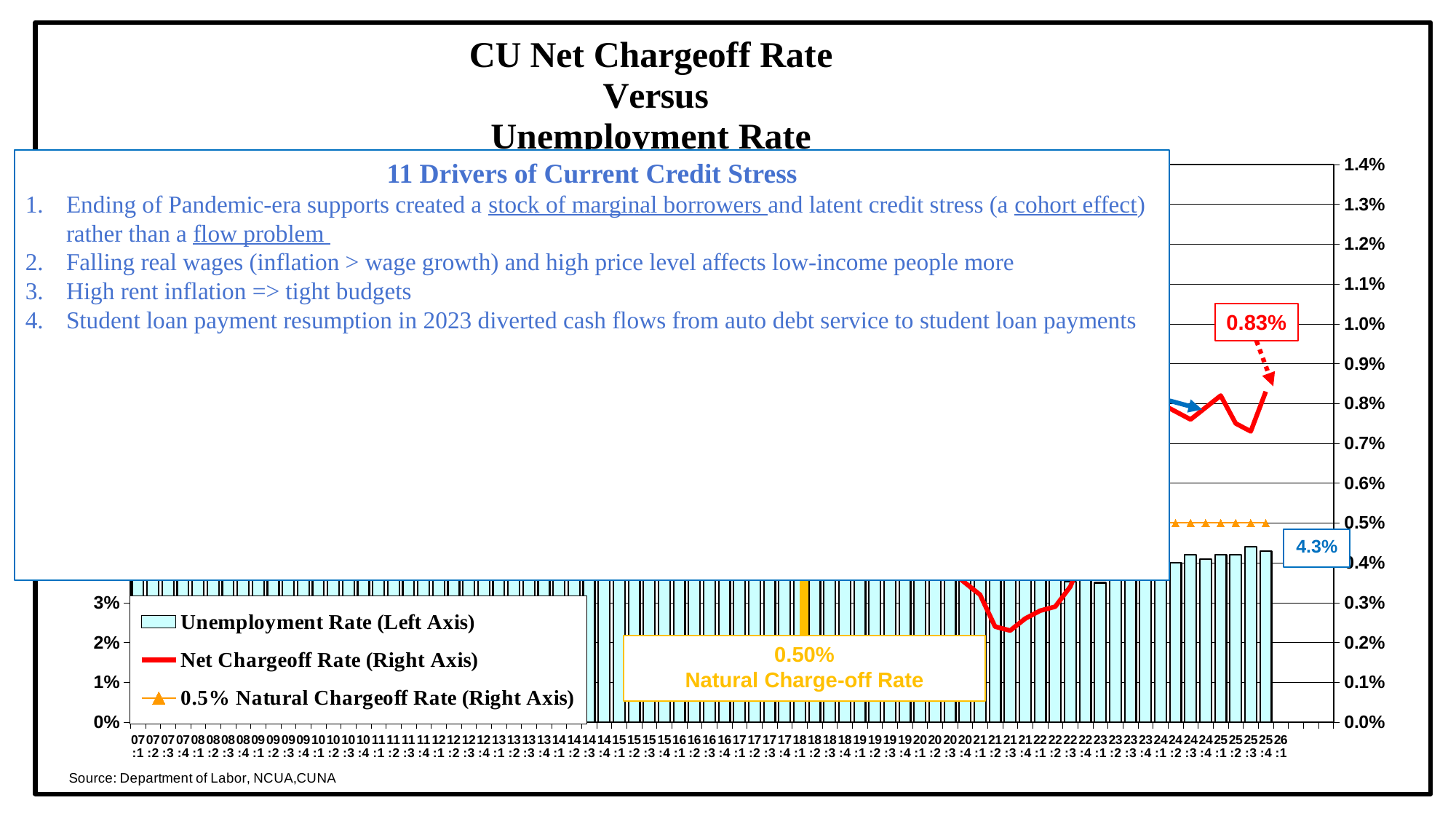
Which is larger, the Net Chargeoff Rate at 25:4 or at 21:3? 25:4 How many series does the chart legend list? 3 What is the highest value shown on the right axis? 1.4% What kind of chart is this? Combined bar and line chart What value is labelled for the projected Net Chargeoff Rate at the right end of the red line? 0.83% Does the Net Chargeoff Rate rise or fall from 21:3 to 25:4? rise What is the Natural Charge-off Rate shown on the chart? 0.50% Is the Net Chargeoff Rate at 25:4 greater or less than 0.5%? greater Is the Net Chargeoff Rate at 21:3 greater or less than 0.3%? less Which series is plotted as bars? Unemployment Rate (Left Axis) What value is labelled for the latest Unemployment Rate bar? 4.3% What is the title of the chart? CU Net Chargeoff Rate Versus Unemployment Rate